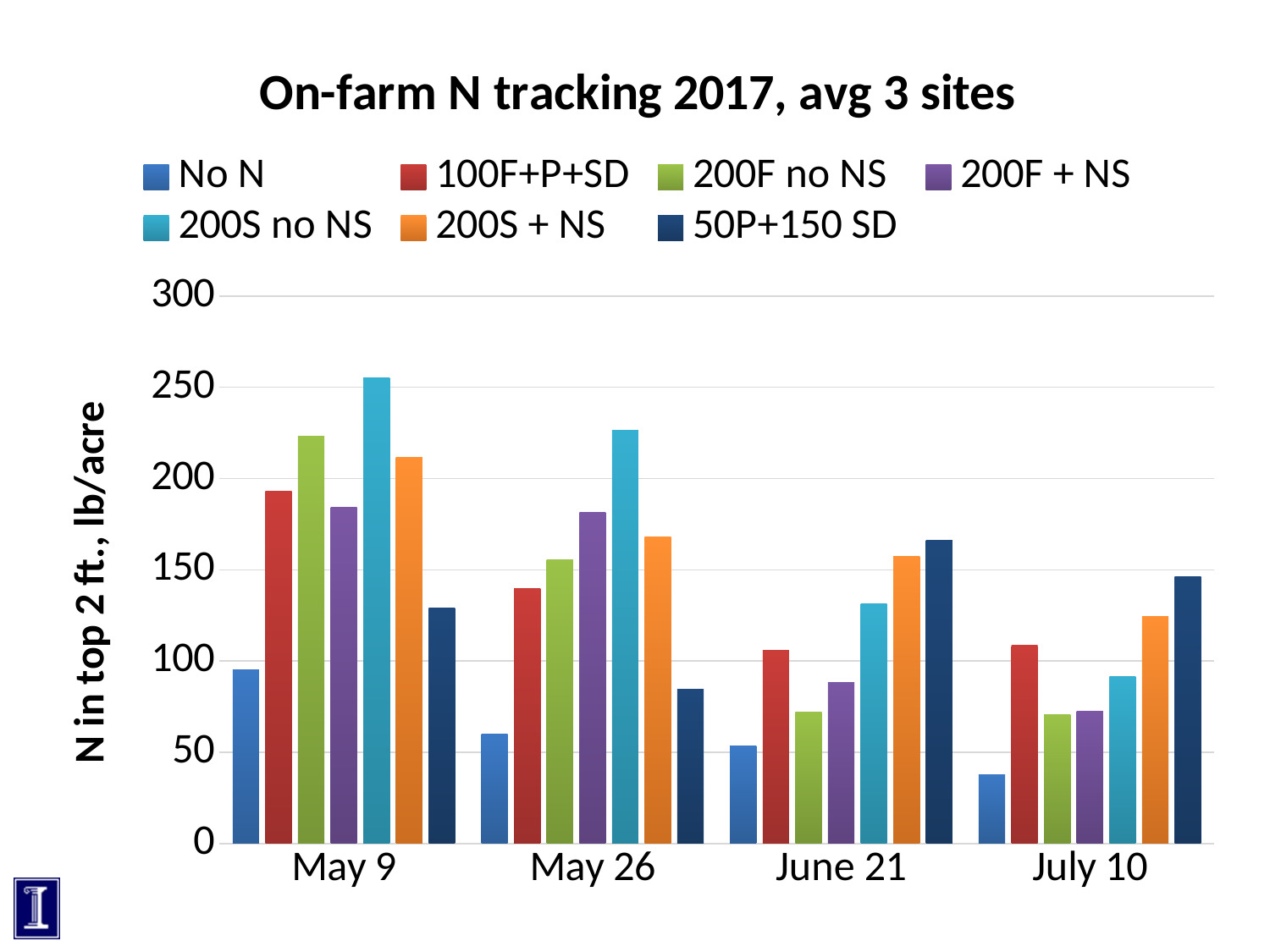
On May 26, which is larger: 200S no NS or 200F + NS? 200S no NS Which treatment has the lowest value on June 21? No N How many series does the legend list? 7 How many sampling dates are shown on the x axis? 4 Do the values for No N rise or fall from May 9 to July 10? fall Is the value for 200S no NS on May 9 greater or less than 200? greater Which treatment has the highest value on May 9? 200S no NS What is the title of the y axis? N in top 2 ft., lb/acre Which treatment has the highest value on July 10? 50P+150 SD Which treatment has the lowest value on May 9? No N What kind of chart is shown on the slide? bar chart Is the value for No N on May 26 greater or less than 100? less